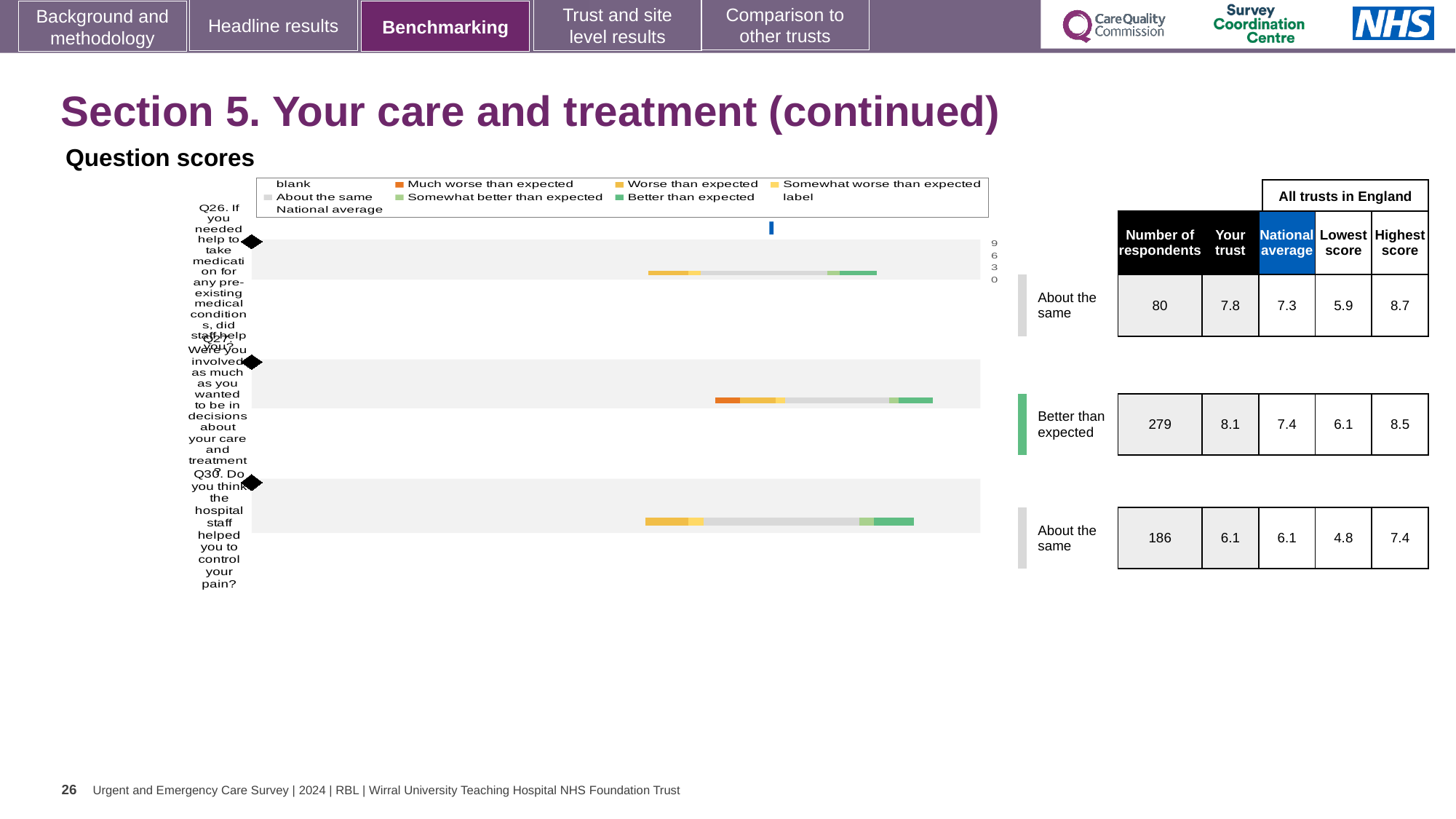
What is the 'Your trust' score for Q26 in the question scores table? 7.8 Which question has the lowest 'Your trust' score? Q30 What is the highest score among all trusts in England for Q26? 8.7 For Q26, is the 'Your trust' score or the national average score larger? Your trust How many questions (rows) are plotted in the question scores chart? 3 In the question scores chart, which question is rated 'Better than expected'? Q27 Which question has the largest number of respondents? Q27 What is the lowest score among all trusts in England for Q30? 4.8 How many respondents answered Q30? 186 What is the national average score for Q27? 7.4 For Q27, what is the difference between the 'Your trust' score and the national average? 0.7 What kind of chart is used to show the question scores on this slide? bar chart